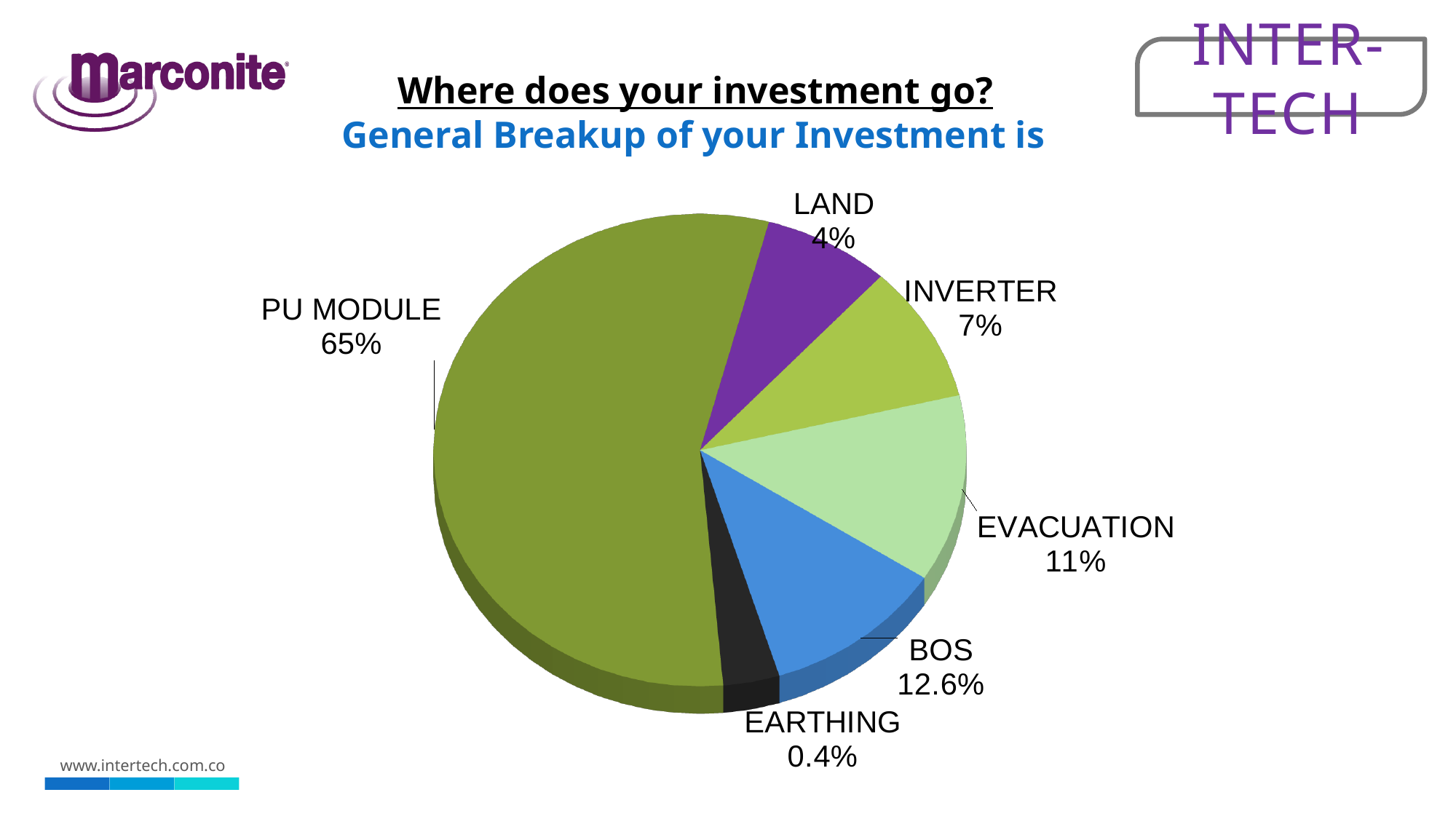
Which has a larger share, INVERTER or LAND? INVERTER What share of the investment goes to EVACUATION? 11% What share of the investment goes to PU MODULE? 65% How many categories are shown in the pie chart? 6 Which category has the smallest share of the investment? EARTHING What share of the investment goes to INVERTER? 7% What colour is the LAND slice? Purple What share of the investment goes to EARTHING? 0.4% What kind of chart is shown on the slide? Pie chart Which category has the largest share of the investment? PU MODULE What share of the investment goes to BOS? 12.6% What is the difference between the shares for BOS and EVACUATION? 1.6%